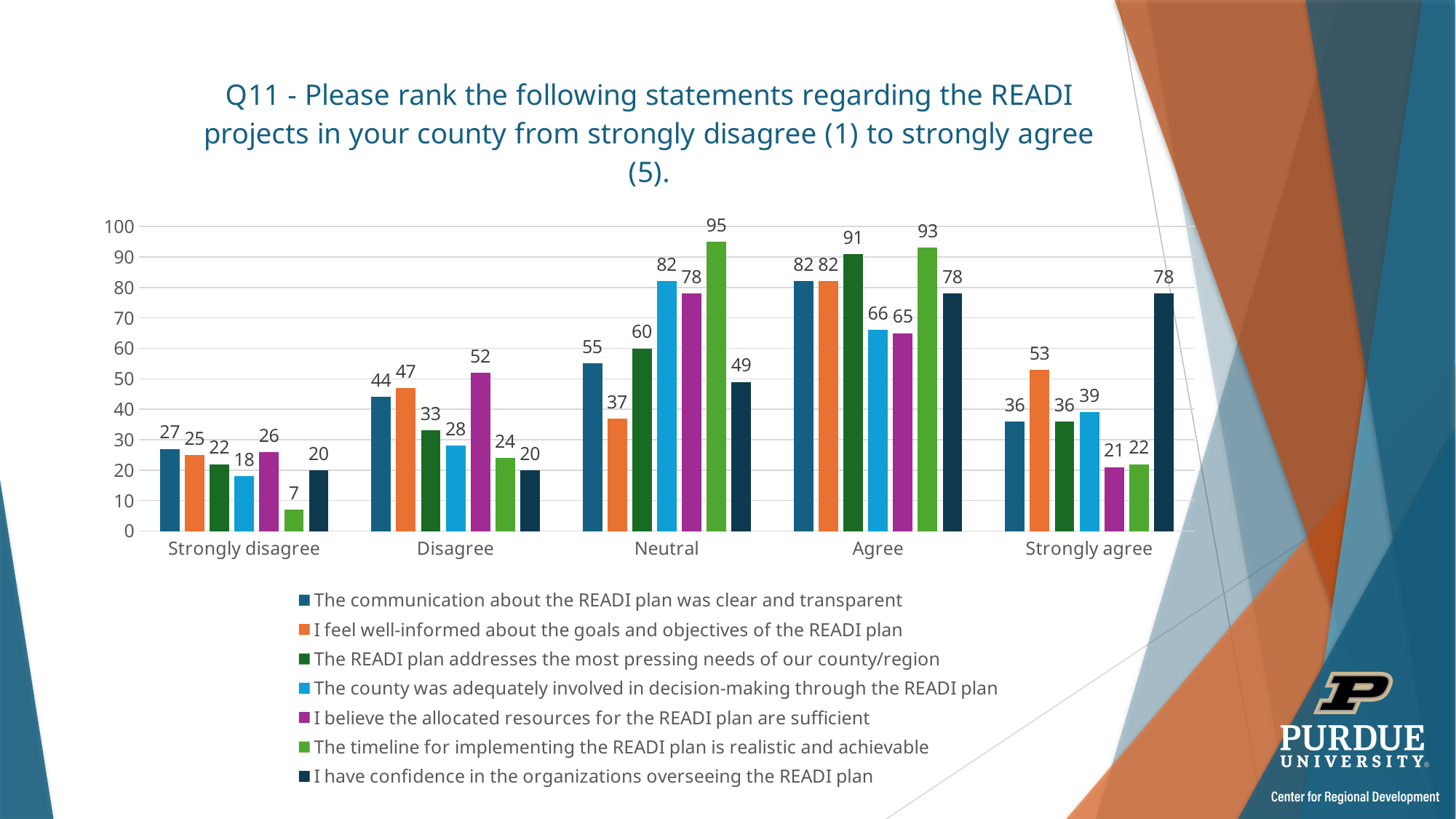
What is the value for "The timeline for implementing the READI plan is realistic and achievable" in the Neutral category? 95 How many categories are shown on the x axis? 5 Which colour represents "I feel well-informed about the goals and objectives of the READI plan" in the legend? Orange Which series has the highest value in the Agree category? The timeline for implementing the READI plan is realistic and achievable What is the difference between the Agree and Strongly agree values for "The READI plan addresses the most pressing needs of our county/region"? 55 What is the value for "I feel well-informed about the goals and objectives of the READI plan" in the Strongly agree category? 53 In the Neutral category, which is larger: the value for "The county was adequately involved in decision-making through the READI plan" or the value for "I believe the allocated resources for the READI plan are sufficient"? The county was adequately involved in decision-making through the READI plan How many series does the legend list? 7 What kind of chart is shown on the slide? Bar chart Which series has the lowest value in the Strongly disagree category? The timeline for implementing the READI plan is realistic and achievable Is the value for "I believe the allocated resources for the READI plan are sufficient" in the Disagree category greater or less than 50? greater What is the value for "I have confidence in the organizations overseeing the READI plan" in the Disagree category? 20